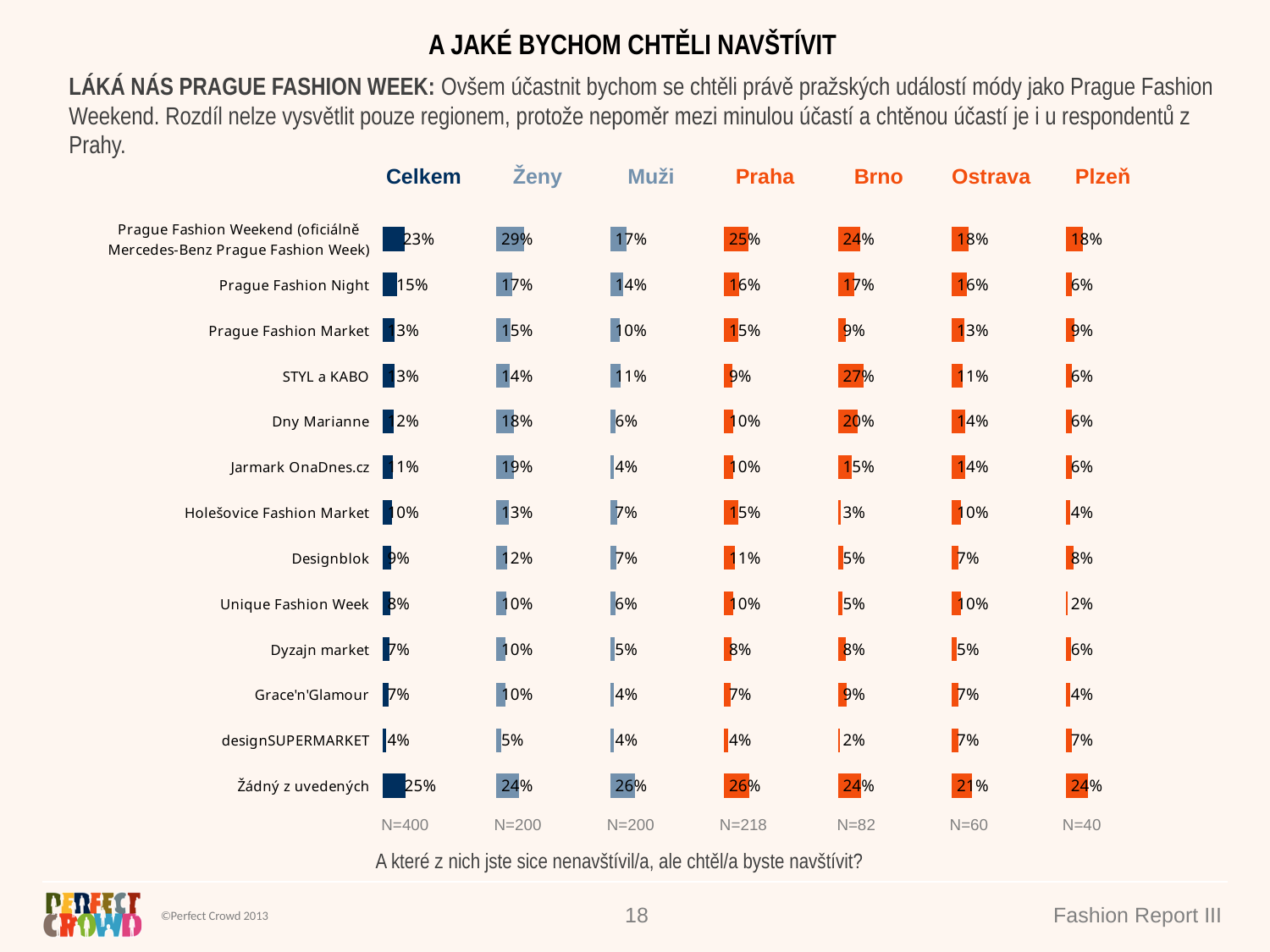
What is the sample size (N) shown for the Praha column? N=218 For Holešovice Fashion Market, which is larger: the Praha value or the Brno value? Praha In the Ženy column, what percentage is shown for Prague Fashion Weekend (oficiálně Mercedes-Benz Prague Fashion Week)? 29% In the Brno column, which event has the highest percentage? STYL a KABO In the Brno column, which event has the lowest percentage? designSUPERMARKET In the Ostrava column, what percentage is shown for Žádný z uvedených? 21% How many event categories (rows) are shown in the chart? 13 In the Brno column, what percentage is shown for STYL a KABO? 27% What kind of chart is used on this slide? Bar chart In the Plzeň column, which event has the lowest percentage? Unique Fashion Week In the Plzeň column, what percentage is shown for Prague Fashion Night? 6% What is the difference between the Ženy and Muži percentages for Prague Fashion Weekend (oficiálně Mercedes-Benz Prague Fashion Week)? 12 percentage points